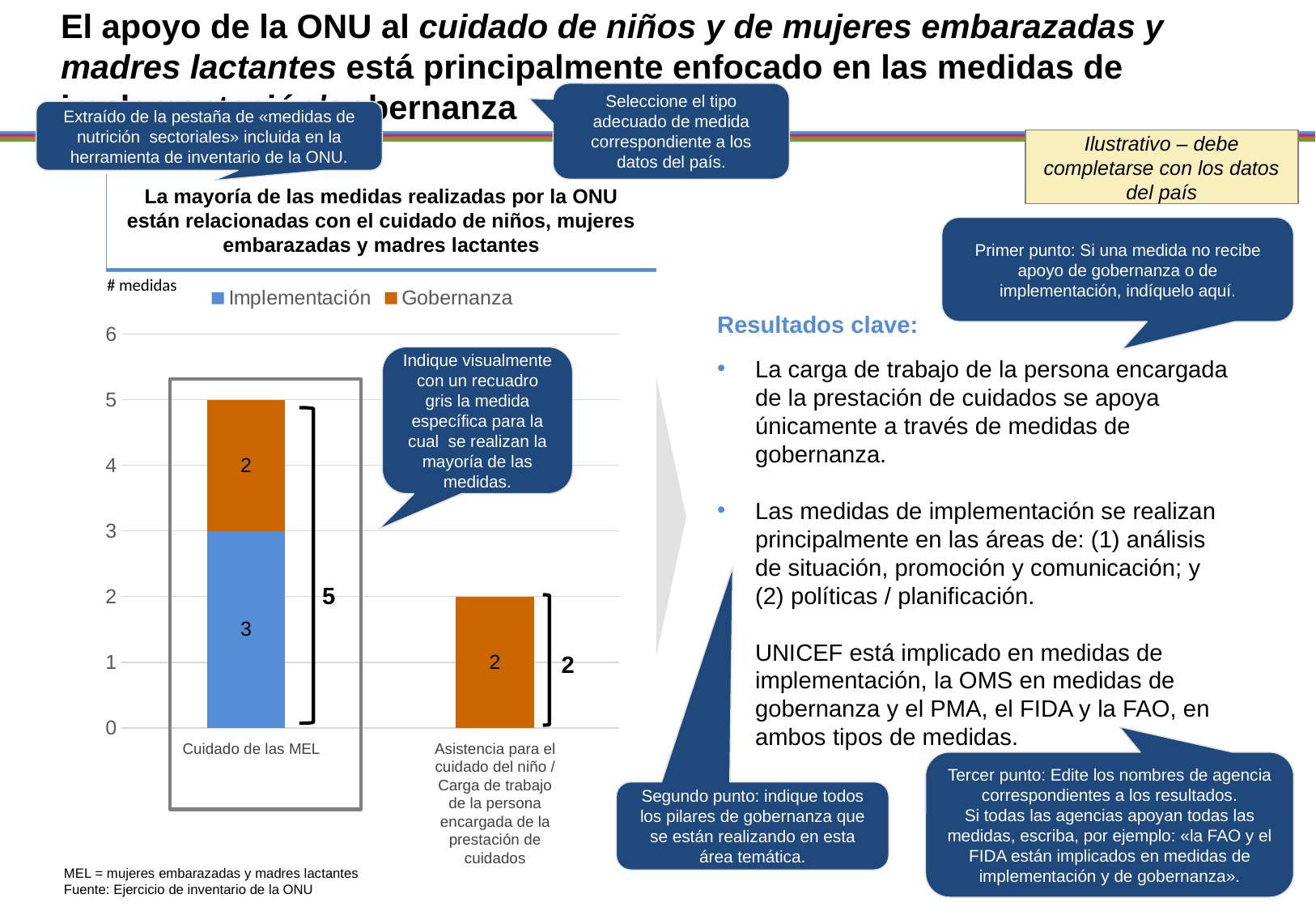
How many series does the chart legend list? 2 What is the total number of measures for the 'Asistencia para el cuidado del niño / Carga de trabajo de la persona encargada de la prestación de cuidados' bar? 2 Which is larger for 'Cuidado de las MEL': the Implementación value or the Gobernanza value? Implementación What is the Gobernanza value for 'Asistencia para el cuidado del niño / Carga de trabajo de la persona encargada de la prestación de cuidados'? 2 What kind of chart is shown on the slide? Stacked bar chart What is the total number of measures for the 'Cuidado de las MEL' bar? 5 How many categories are shown on the x axis of the chart? 2 What is the Gobernanza value for 'Cuidado de las MEL'? 2 Which two series are listed in the chart legend? Implementación and Gobernanza Which category has the highest total number of measures? Cuidado de las MEL What is the Implementación value for 'Cuidado de las MEL'? 3 What is the difference between the total for 'Cuidado de las MEL' and the total for 'Asistencia para el cuidado del niño / Carga de trabajo de la persona encargada de la prestación de cuidados'? 3